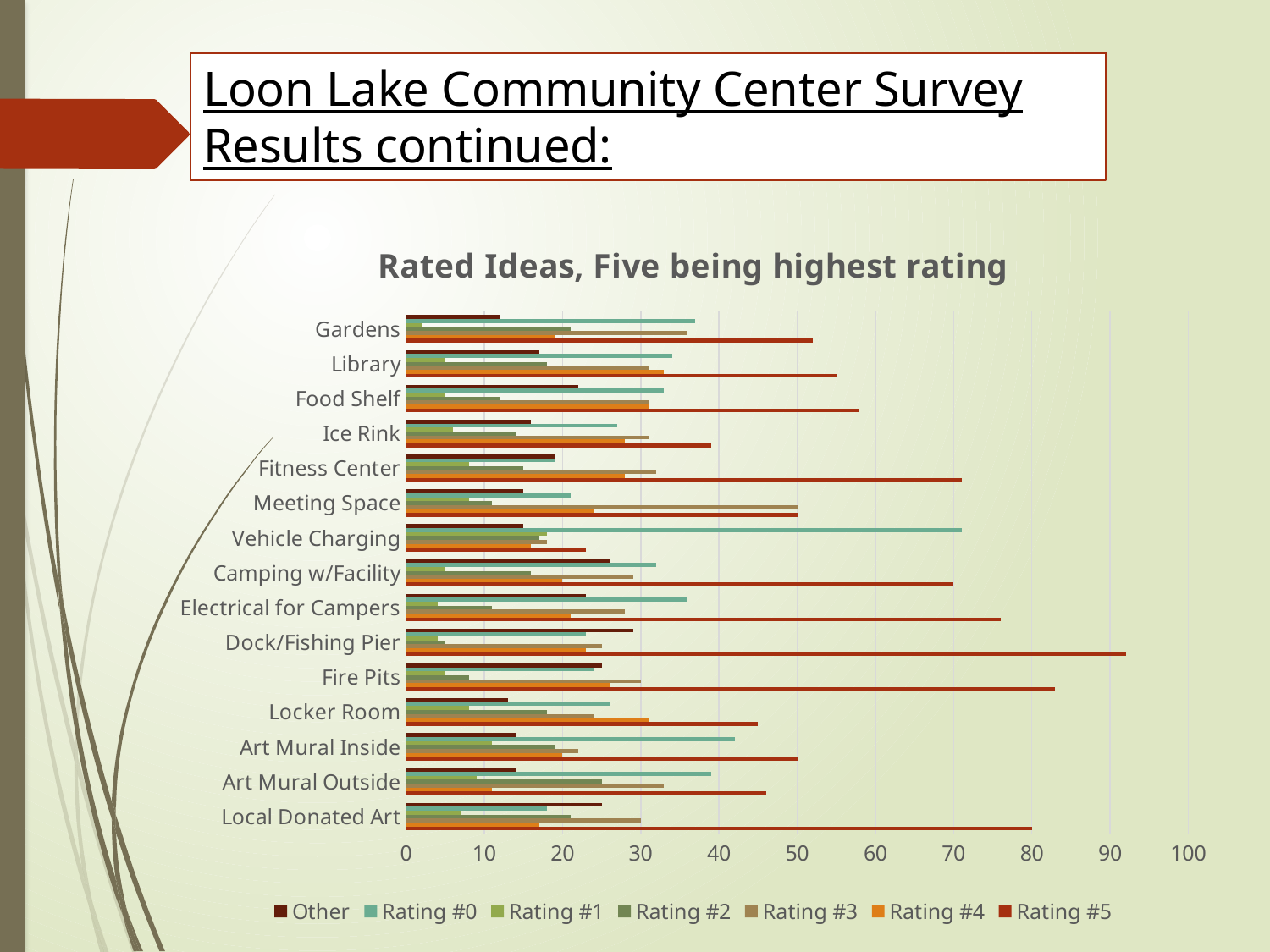
What is the title of the chart? Rated Ideas, Five being highest rating How many ideas (categories) are listed on the chart? 15 How many series does the chart's legend list? 7 Which idea has the highest Rating #0 value? Vehicle Charging What kind of chart is shown on the slide? Bar chart Which has the larger Rating #5 value, Fire Pits or Locker Room? Fire Pits Which idea has the highest Rating #5 value? Dock/Fishing Pier Which has the larger Rating #0 value, Vehicle Charging or Fitness Center? Vehicle Charging Is the Rating #5 value for Vehicle Charging greater or less than 30? less Is the Rating #5 value for Fitness Center greater or less than 60? greater Which idea has the lowest Rating #5 value? Vehicle Charging Is the Rating #5 value for Dock/Fishing Pier greater or less than 80? greater